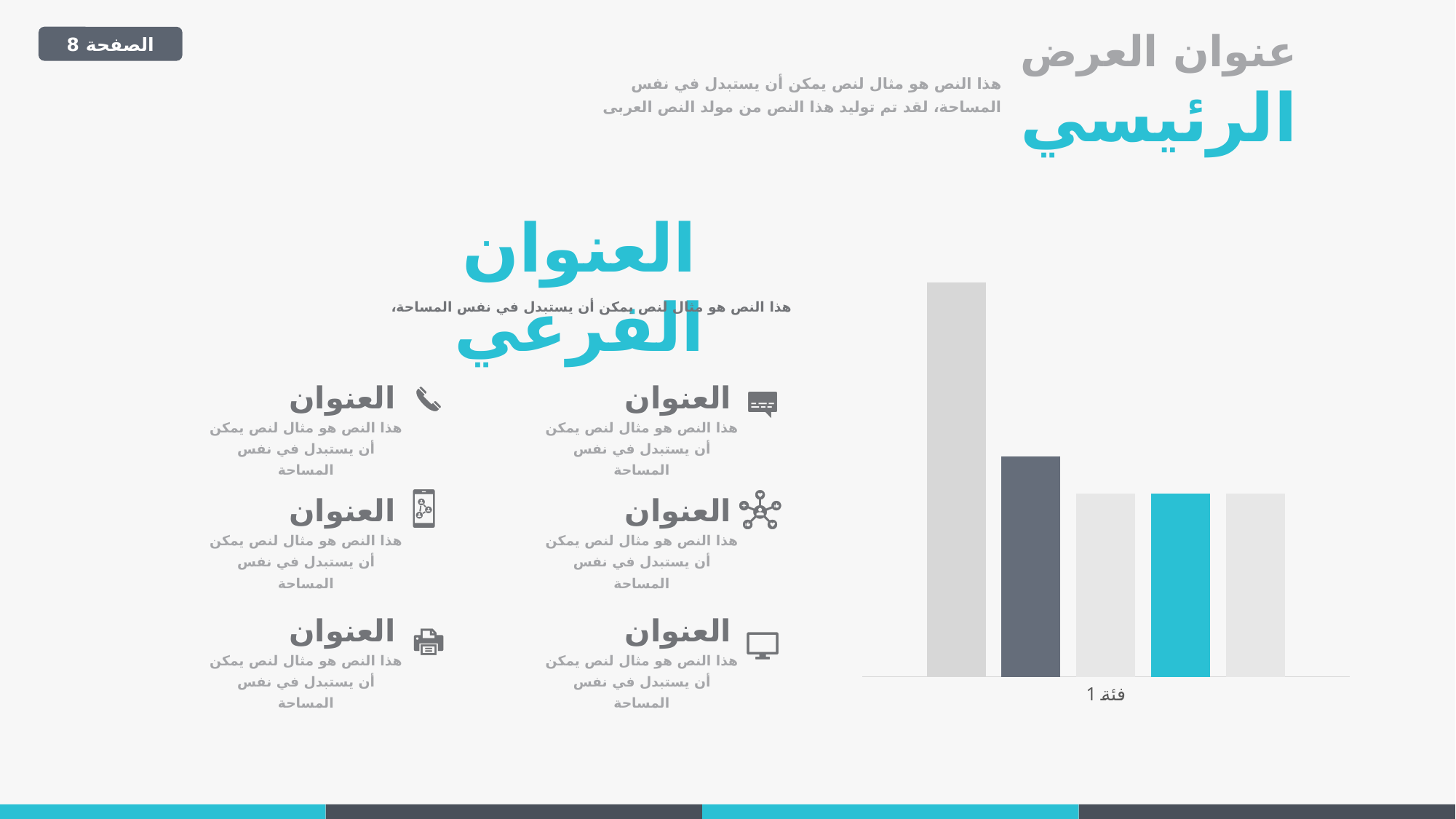
How many category labels appear on the x axis of the chart? 1 What is the category label shown on the x axis of the chart? فئة 1 Do the bar heights rise or fall from left to right across the first three bars? fall Which bar in the chart is the tallest? the leftmost bar What colour is the fourth bar from the left in the chart? teal Is the leftmost bar or the second bar from the left taller? the leftmost bar What kind of chart is shown on the right side of the slide? bar chart Does the chart display a legend? No Is the second bar from the left taller or shorter than the rightmost bar? taller How many bars are plotted in the chart? 5